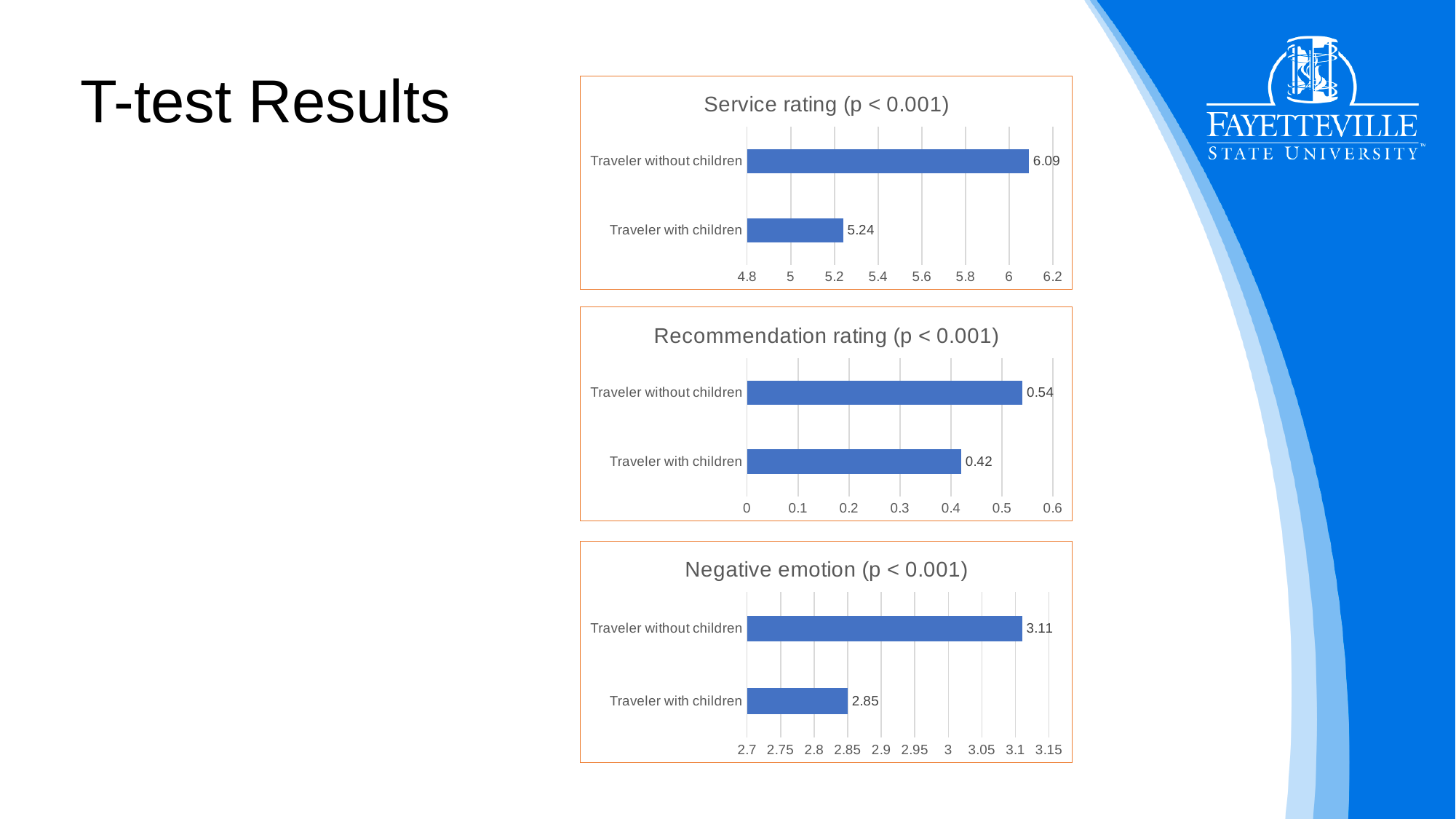
In the 'Recommendation rating (p < 0.001)' chart, which category has the highest value? Traveler without children What type of chart is the 'Recommendation rating (p < 0.001)' chart? Bar chart In the 'Service rating (p < 0.001)' chart, which is larger: the value for Traveler with children or Traveler without children? Traveler without children In the 'Service rating (p < 0.001)' chart, what is the value for Traveler without children? 6.09 In the 'Recommendation rating (p < 0.001)' chart, what is the difference between the two values? 0.12 How many categories does the 'Negative emotion (p < 0.001)' chart show? 2 In the 'Recommendation rating (p < 0.001)' chart, what is the value for Traveler with children? 0.42 In the 'Negative emotion (p < 0.001)' chart, what is the value for Traveler without children? 3.11 In the 'Negative emotion (p < 0.001)' chart, is the value for Traveler without children greater or less than 3? greater In the 'Service rating (p < 0.001)' chart, what is the difference between the values for Traveler without children and Traveler with children? 0.85 In the 'Service rating (p < 0.001)' chart, what is the value for Traveler with children? 5.24 In the 'Negative emotion (p < 0.001)' chart, which category has the lowest value? Traveler with children